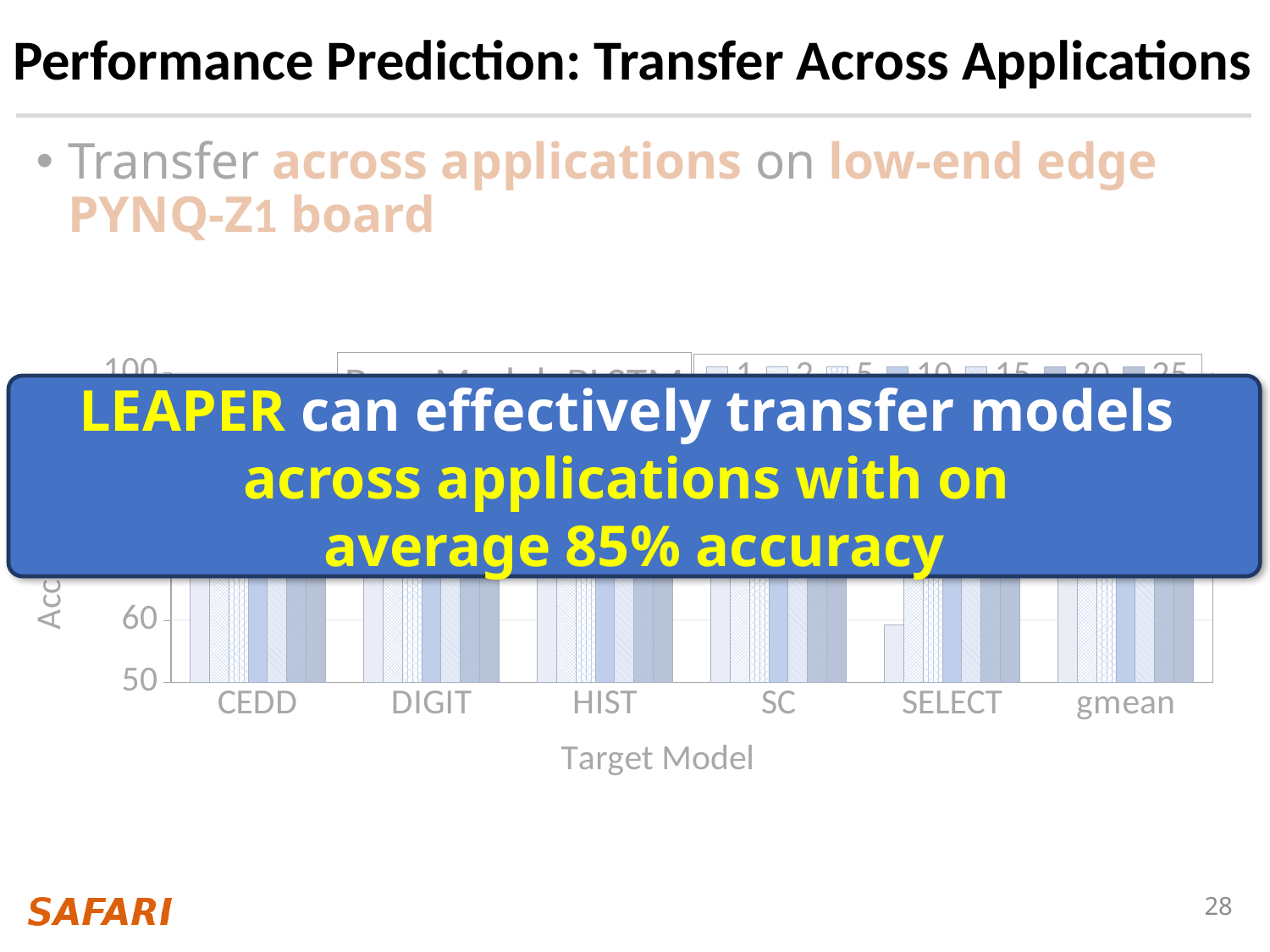
Is the shortest bar in the CEDD group greater or less than 60? greater What is the lowest tick value shown on the y axis of the chart? 50 What is the last category label on the x axis of the chart? gmean Which category on the x axis contains a bar that falls below 60? SELECT What is the title of the x axis of the chart? Target Model What kind of chart is shown on the slide? bar chart How many categories are shown along the x axis of the chart? 6 Is the shortest bar in the SELECT group greater or less than 60? less